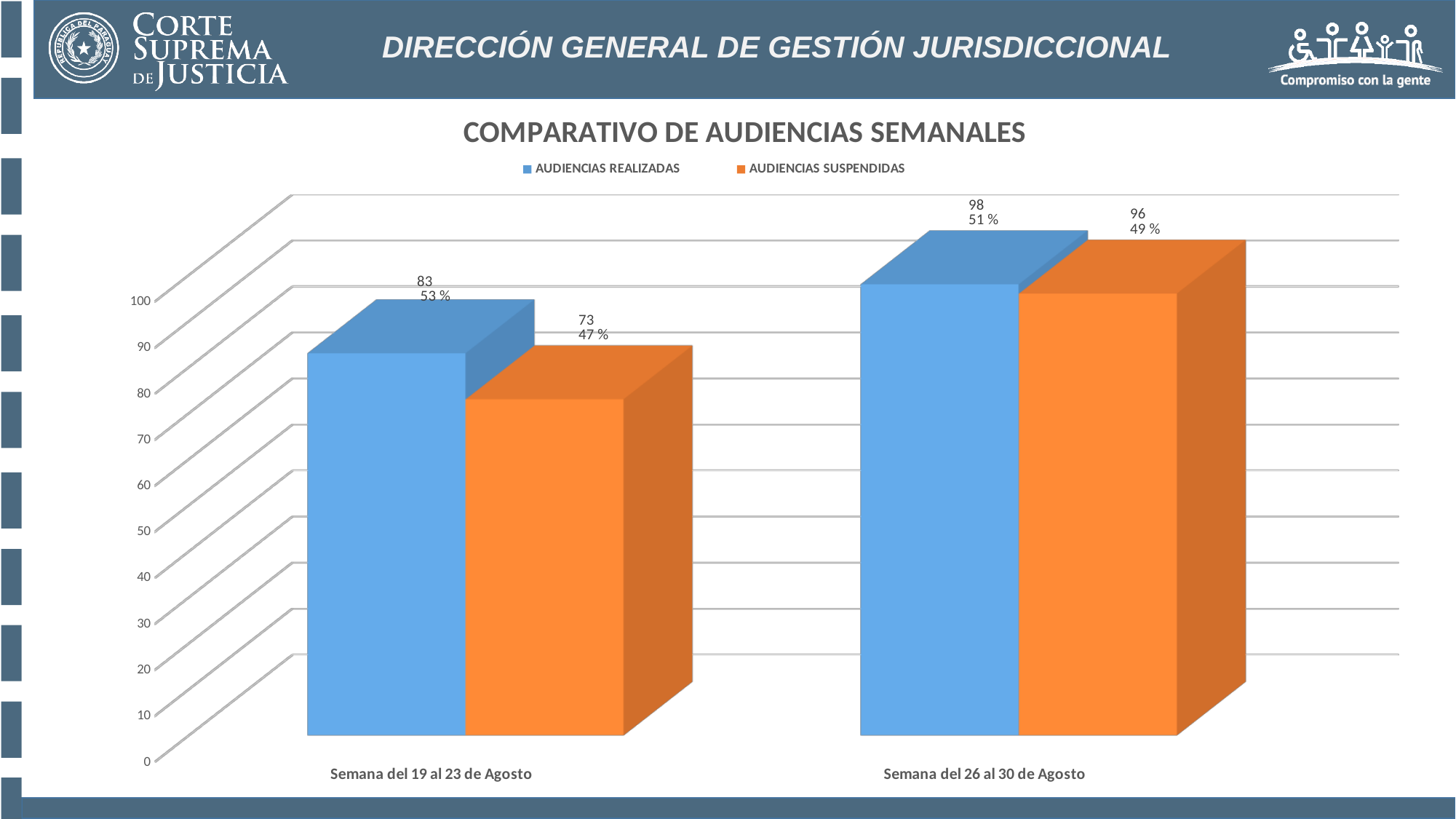
How many series does the legend list? 2 What is the difference between AUDIENCIAS REALIZADAS and AUDIENCIAS SUSPENDIDAS in Semana del 19 al 23 de Agosto? 10 What is the value of AUDIENCIAS REALIZADAS for Semana del 19 al 23 de Agosto? 83 What percentage is shown for AUDIENCIAS REALIZADAS in Semana del 26 al 30 de Agosto? 51 % In Semana del 26 al 30 de Agosto, which is larger: AUDIENCIAS REALIZADAS or AUDIENCIAS SUSPENDIDAS? AUDIENCIAS REALIZADAS By how much did AUDIENCIAS SUSPENDIDAS increase from Semana del 19 al 23 de Agosto to Semana del 26 al 30 de Agosto? 23 What is the value of AUDIENCIAS SUSPENDIDAS for Semana del 26 al 30 de Agosto? 96 Which week has the lowest value for AUDIENCIAS SUSPENDIDAS? Semana del 19 al 23 de Agosto Which week has the higher value for AUDIENCIAS REALIZADAS? Semana del 26 al 30 de Agosto What percentage is shown for AUDIENCIAS SUSPENDIDAS in Semana del 19 al 23 de Agosto? 47 % What is the title of the chart? COMPARATIVO DE AUDIENCIAS SEMANALES What kind of chart is shown on the slide? Bar chart